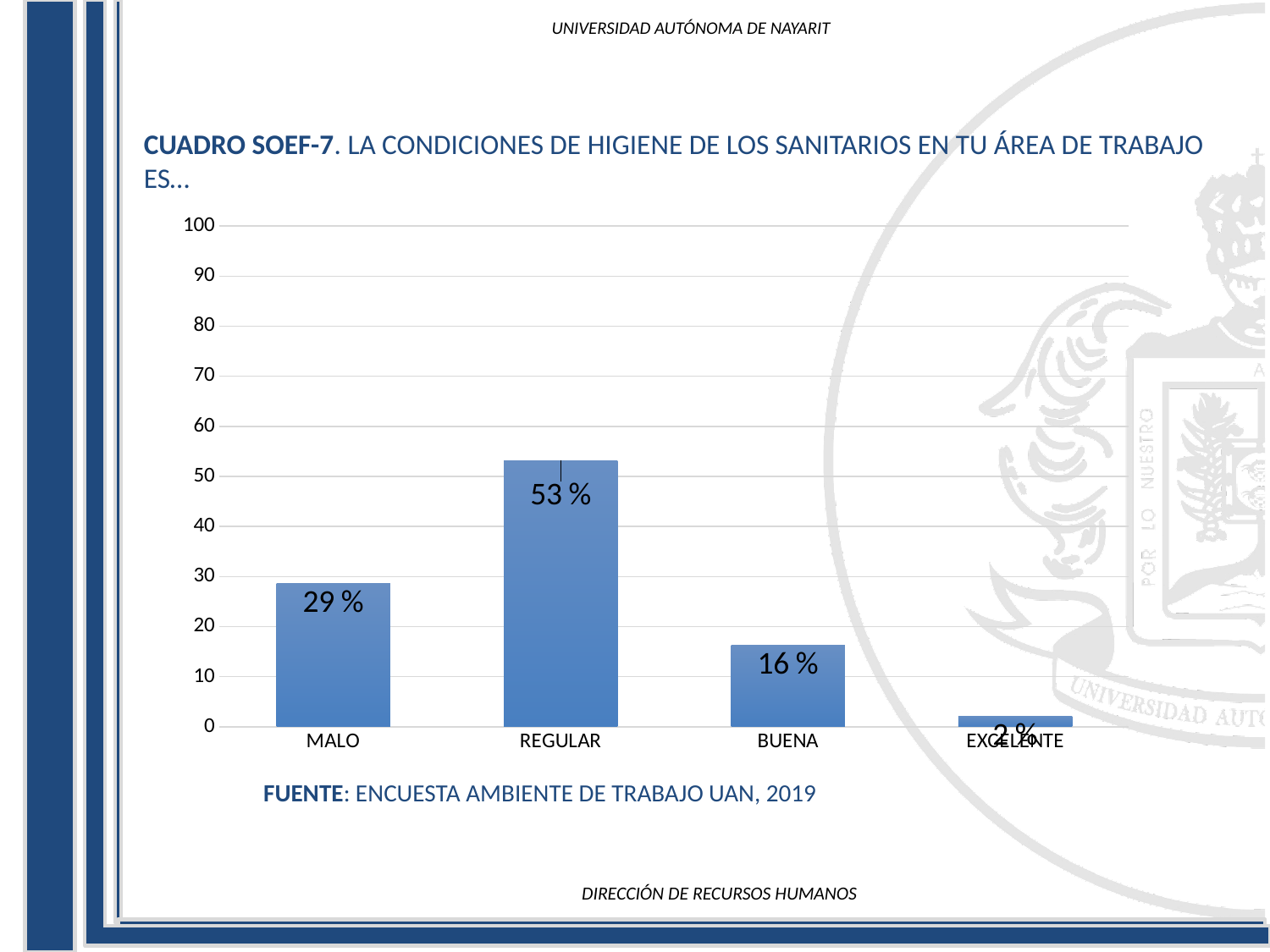
What is the value shown for MALO? 29 % What is the difference between the values for MALO and BUENA? 13 % What is the value shown for BUENA? 16 % Which is larger, the value for MALO or the value for BUENA? MALO What kind of chart is shown on the slide? bar chart Which category has the lowest value? EXCELENTE How many categories are shown on the x axis? 4 What source is cited below the chart? ENCUESTA AMBIENTE DE TRABAJO UAN, 2019 What is the value shown for REGULAR? 53 % What is the difference between the values for REGULAR and MALO? 24 % Is the value for EXCELENTE greater or less than 10? less Which category has the highest value? REGULAR